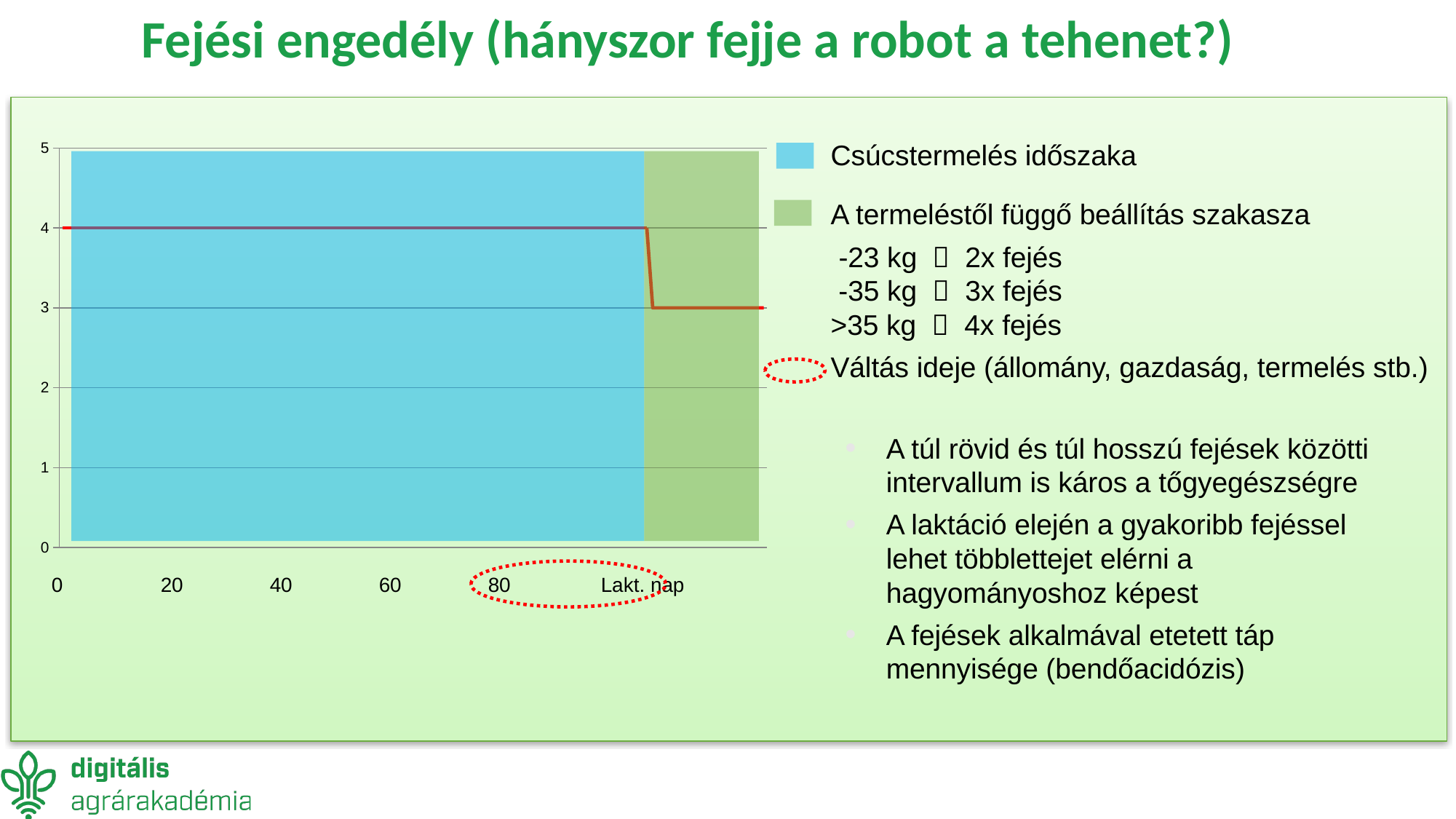
How many shaded regions does the legend list? 2 What kind of chart is shown on the slide? line chart By how much does the red line drop when it moves from the blue region to the green region? 1 Does the red line rise or fall as lactation days increase? fall What is the highest value shown on the vertical axis? 5 What is the value of the red line at lactation day 60? 4 What label does the legend give to the blue shaded region? Csúcstermelés időszaka What value does the red line drop to in the green shaded region? 3 Is the value of the red line in the green shaded region greater or less than 4? less Which is larger: the value of the red line at day 20 or its value in the green shaded region? day 20 What is the value of the red line at lactation day 20? 4 Is the value of the red line at lactation day 40 greater or less than 3? greater